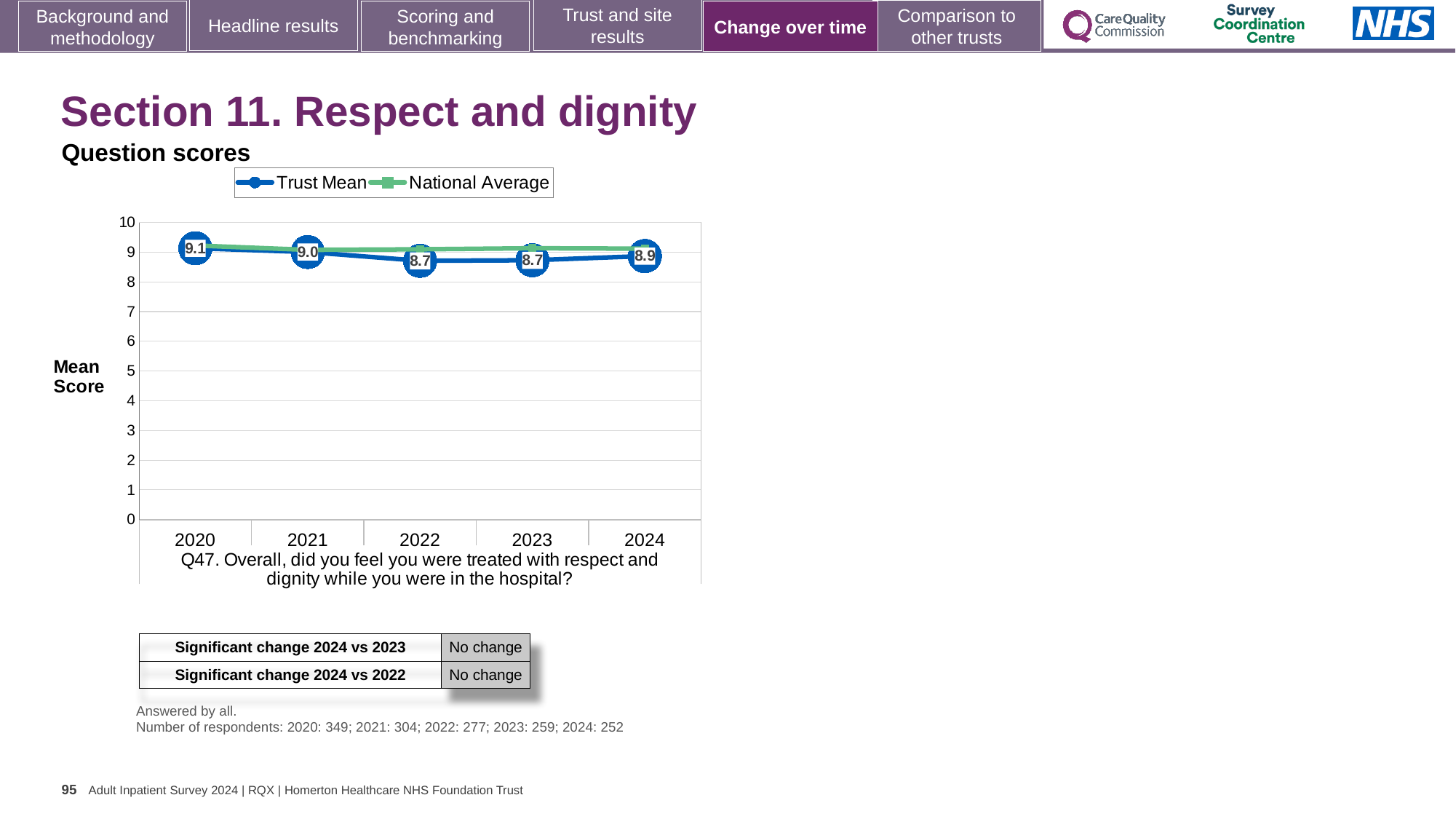
What kind of chart is shown on the slide? Line chart How many years are plotted on the x axis? 5 How many series does the legend list? 2 In which year is the Trust Mean score highest? 2020 What is the Trust Mean score for 2022? 8.7 Is the National Average value for 2022 greater or less than 8? greater What is the Trust Mean score for 2024? 8.9 What is the difference between the Trust Mean scores for 2020 and 2022? 0.4 What is the Trust Mean score for 2020? 9.1 Does the Trust Mean score rise or fall from 2021 to 2022? Fall Which year has the larger Trust Mean score, 2023 or 2024? 2024 What are the two series named in the legend? Trust Mean and National Average